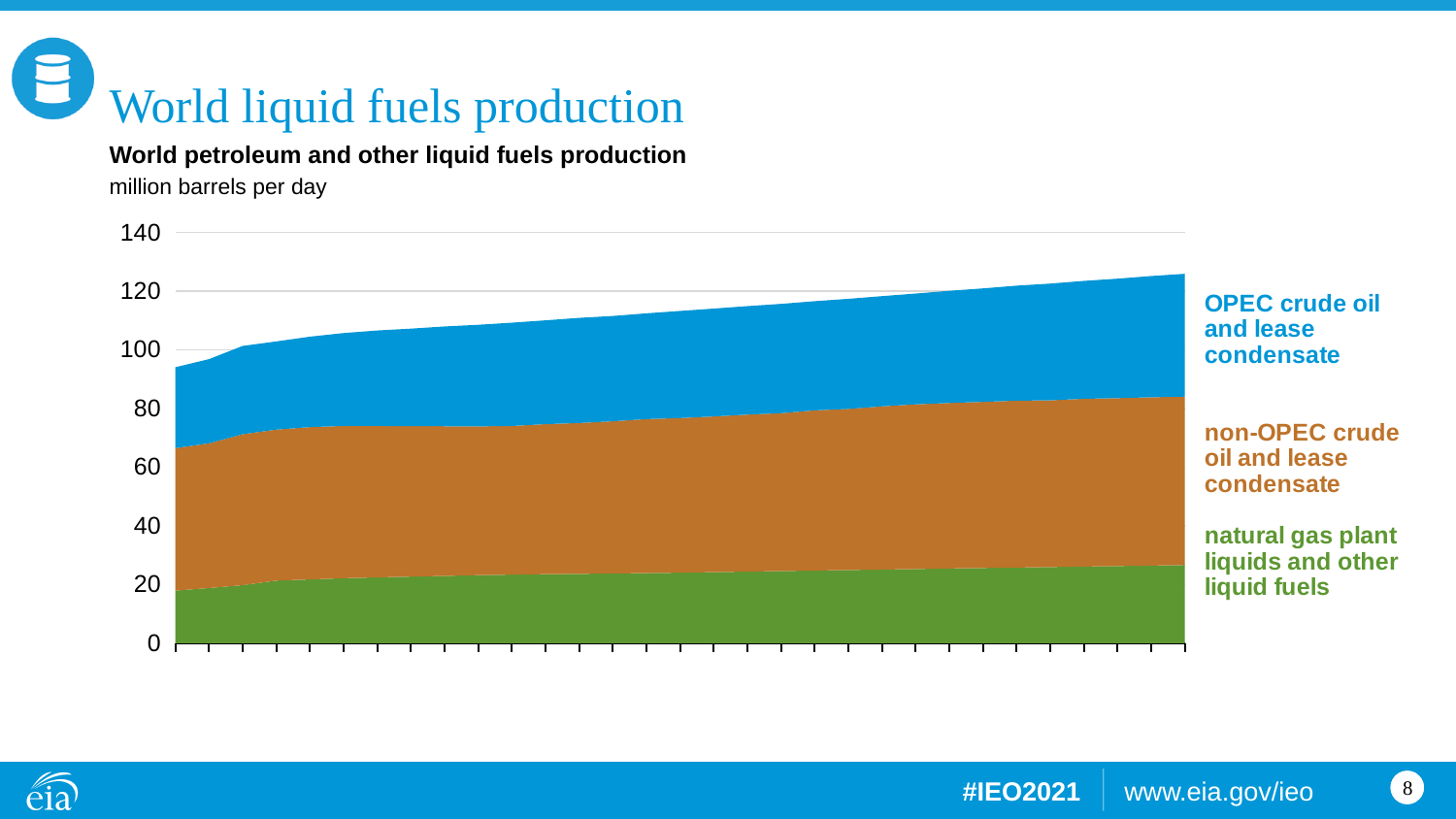
What is the title of the chart? World petroleum and other liquid fuels production What kind of chart is shown on the slide? Stacked area chart Which series is shown in blue? OPEC crude oil and lease condensate What unit is the chart's y axis measured in? million barrels per day Is the total production at the left end of the chart greater or less than 80? greater How many series are shown in the chart? 3 Does total world liquid fuels production rise or fall along the x axis? Rise Is the value for natural gas plant liquids and other liquid fuels at the right end of the chart greater or less than 40? less Is the value for natural gas plant liquids and other liquid fuels at the left end of the chart greater or less than 20? less